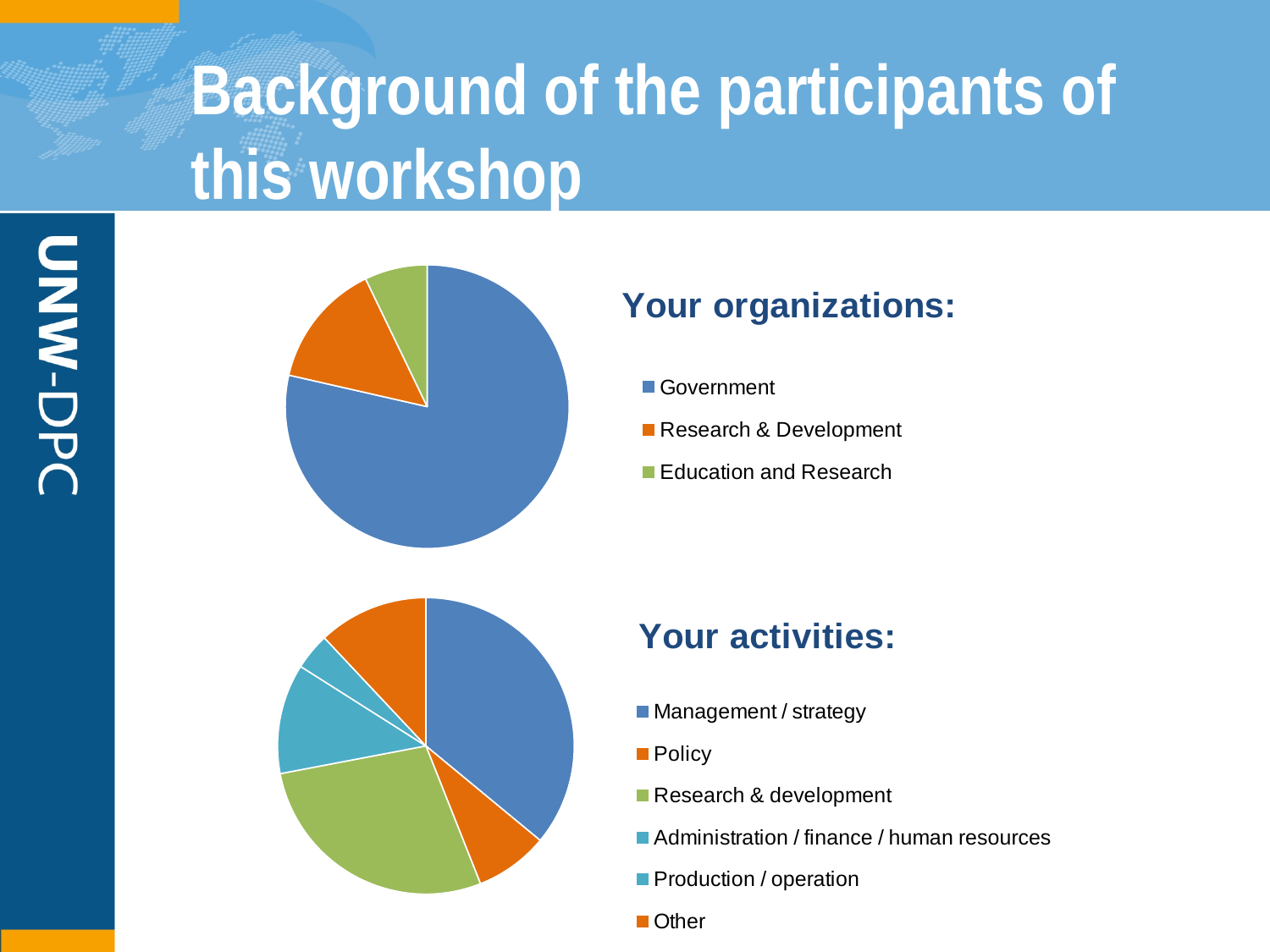
In the 'Your organizations' chart, which slice is larger: Research & Development or Education and Research? Research & Development What colour is the Government slice in the 'Your organizations' chart? blue In the 'Your activities' chart, which slice is larger: Administration / finance / human resources or Production / operation? Administration / finance / human resources How many categories does the legend of the 'Your organizations' chart list? 3 How many categories does the legend of the 'Your activities' chart list? 6 What type of chart is used for 'Your activities'? pie chart In the 'Your activities' chart, which slice is larger: Management / strategy or Research & development? Management / strategy In the 'Your activities' chart, which category has the smallest slice? Production / operation In the 'Your organizations' chart, which category has the largest slice? Government In the 'Your organizations' chart, which category has the smallest slice? Education and Research In the 'Your activities' chart, which category has the largest slice? Management / strategy What type of chart is used for 'Your organizations'? pie chart